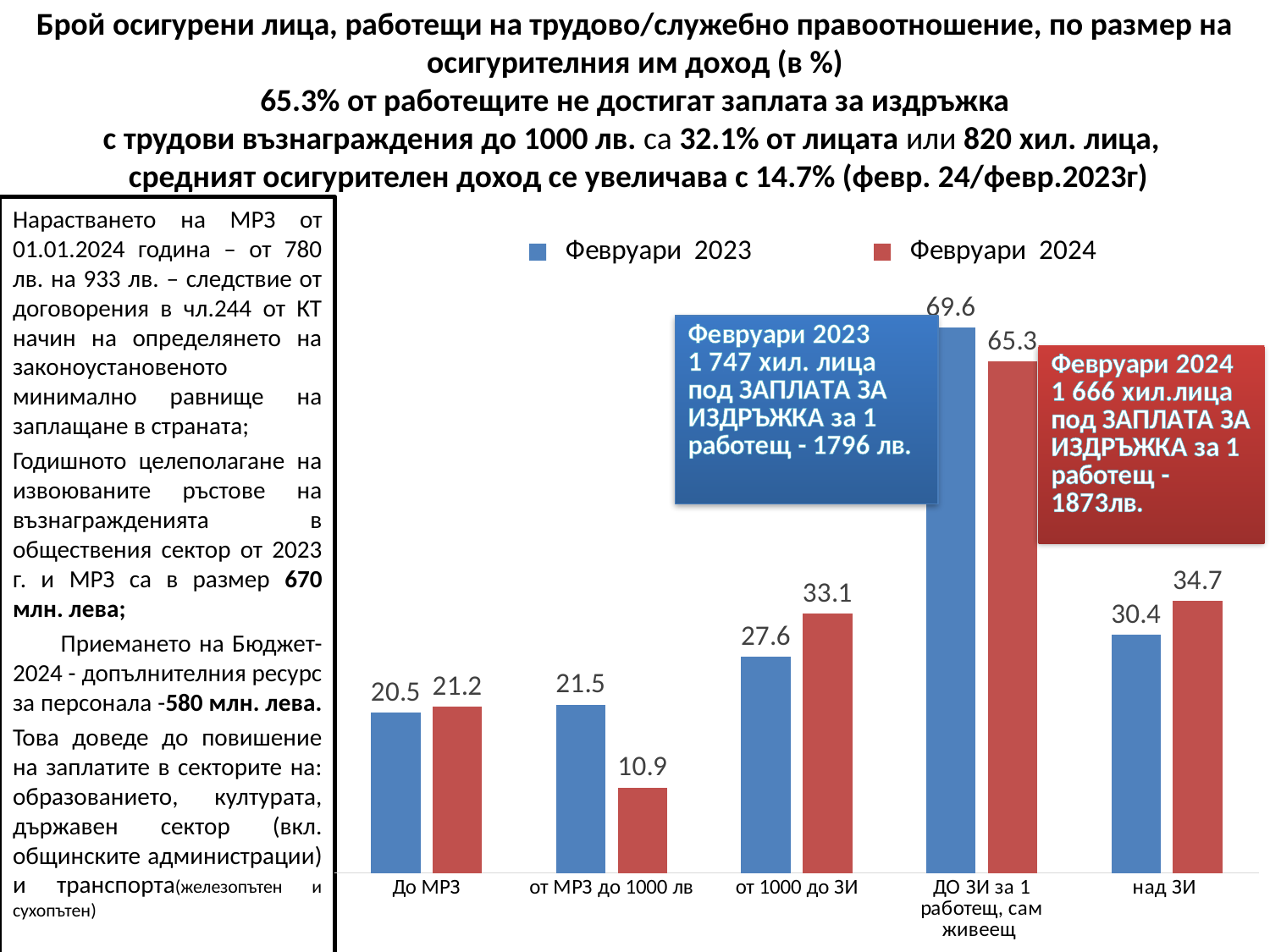
How many series does the chart legend list? 2 What is the value for "До МРЗ" in the Февруари 2023 series? 20.5 What is the value for "над ЗИ" in the Февруари 2024 series? 34.7 For "над ЗИ", which series has the larger value, Февруари 2023 or Февруари 2024? Февруари 2024 What is the difference between the Февруари 2023 and Февруари 2024 values for "от МРЗ до 1000 лв"? 10.6 What is the difference between the Февруари 2024 and Февруари 2023 values for "от 1000 до ЗИ"? 5.5 Which category has the lowest value in the Февруари 2024 series? от МРЗ до 1000 лв Which category has the highest value in the Февруари 2023 series? ДО ЗИ за 1 работещ, сам живеещ What is the value for "от МРЗ до 1000 лв" in the Февруари 2024 series? 10.9 For "ДО ЗИ за 1 работещ, сам живеещ", which series has the larger value, Февруари 2023 or Февруари 2024? Февруари 2023 What type of chart is shown on the slide? Bar chart How many categories are shown on the x axis of the chart? 5